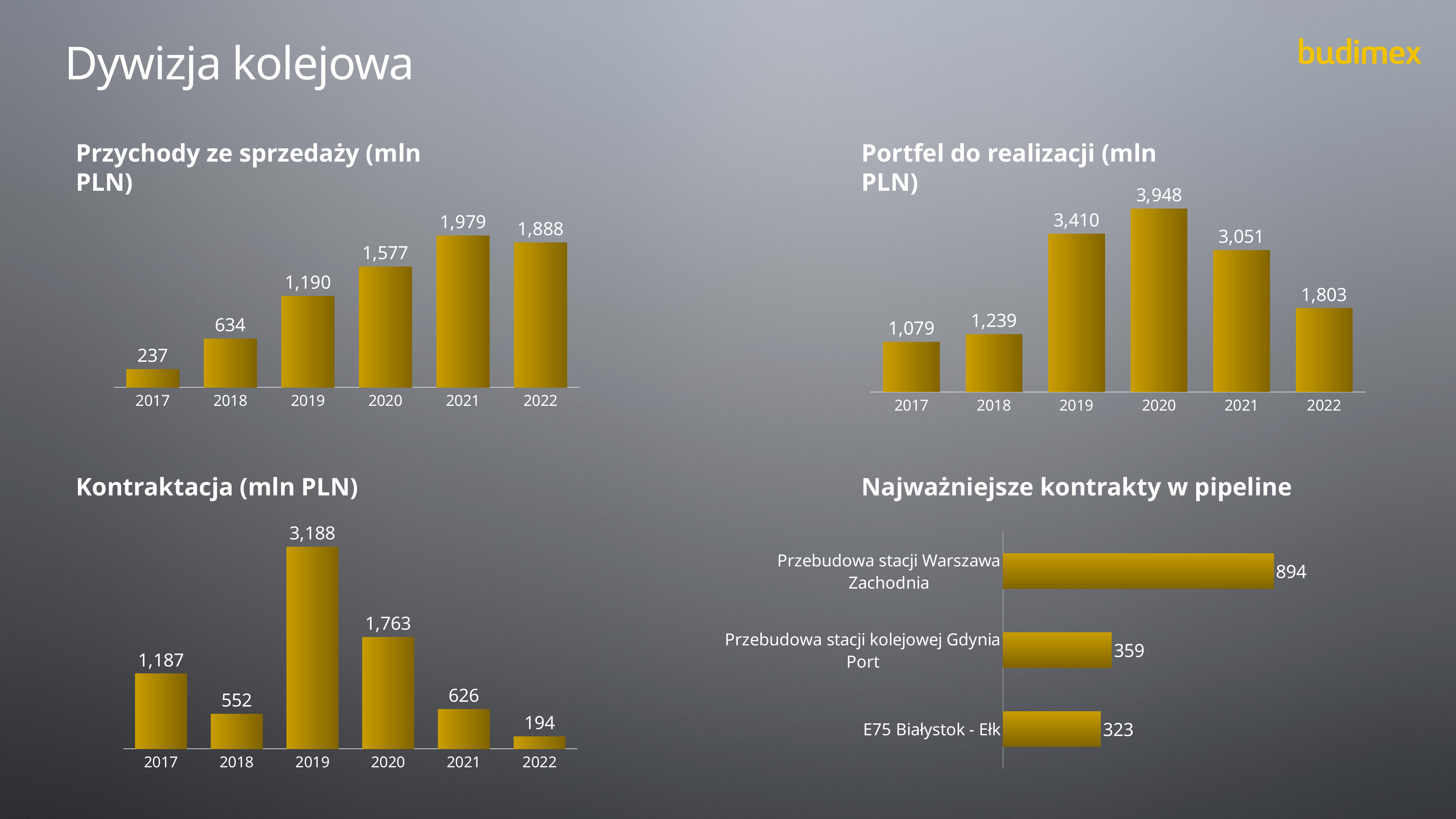
In the 'Przychody ze sprzedaży (mln PLN)' chart, what is the value for 2020? 1,577 In the 'Przychody ze sprzedaży (mln PLN)' chart, which year has the highest value? 2021 In the 'Najważniejsze kontrakty w pipeline' chart, what is the value for 'E75 Białystok - Ełk'? 323 In the 'Portfel do realizacji (mln PLN)' chart, which is larger, the value for 2021 or the value for 2022? 2021 In the 'Przychody ze sprzedaży (mln PLN)' chart, what is the difference between the 2021 and 2022 values? 91 In the 'Kontraktacja (mln PLN)' chart, which year has the lowest value? 2022 What kind of chart is the 'Najważniejsze kontrakty w pipeline' chart? bar chart In the 'Portfel do realizacji (mln PLN)' chart, what is the value for 2019? 3,410 How many contracts are shown in the 'Najważniejsze kontrakty w pipeline' chart? 3 In the 'Kontraktacja (mln PLN)' chart, what is the difference between the 2020 and 2021 values? 1,137 In the 'Kontraktacja (mln PLN)' chart, what is the value for 2019? 3,188 In the 'Portfel do realizacji (mln PLN)' chart, which year has the lowest value? 2017